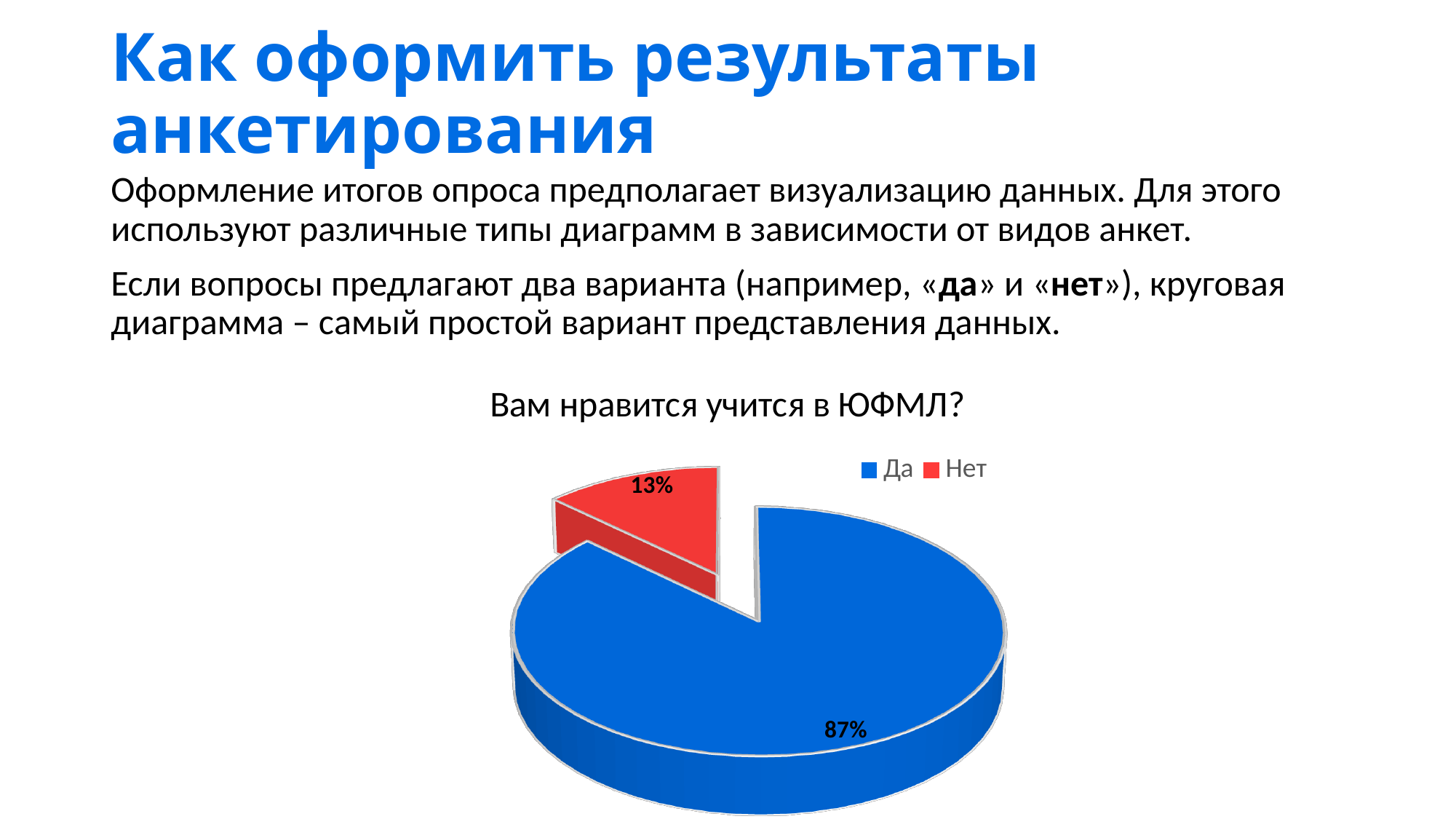
Which is larger, the "Да" slice or the "Нет" slice? Да What colour is the "Нет" slice? red How many slices does the pie chart have? 2 What share of the pie does the "Нет" slice represent? 13% How many entries does the legend list? 2 What is the title of the chart? Вам нравится учится в ЮФМЛ? Which slice is the largest in the pie chart? Да Which slice is the smallest in the pie chart? Нет What is the difference in percentage points between the "Да" and "Нет" slices? 74 What kind of chart is shown on the slide? pie chart What share of the pie does the "Да" slice represent? 87%